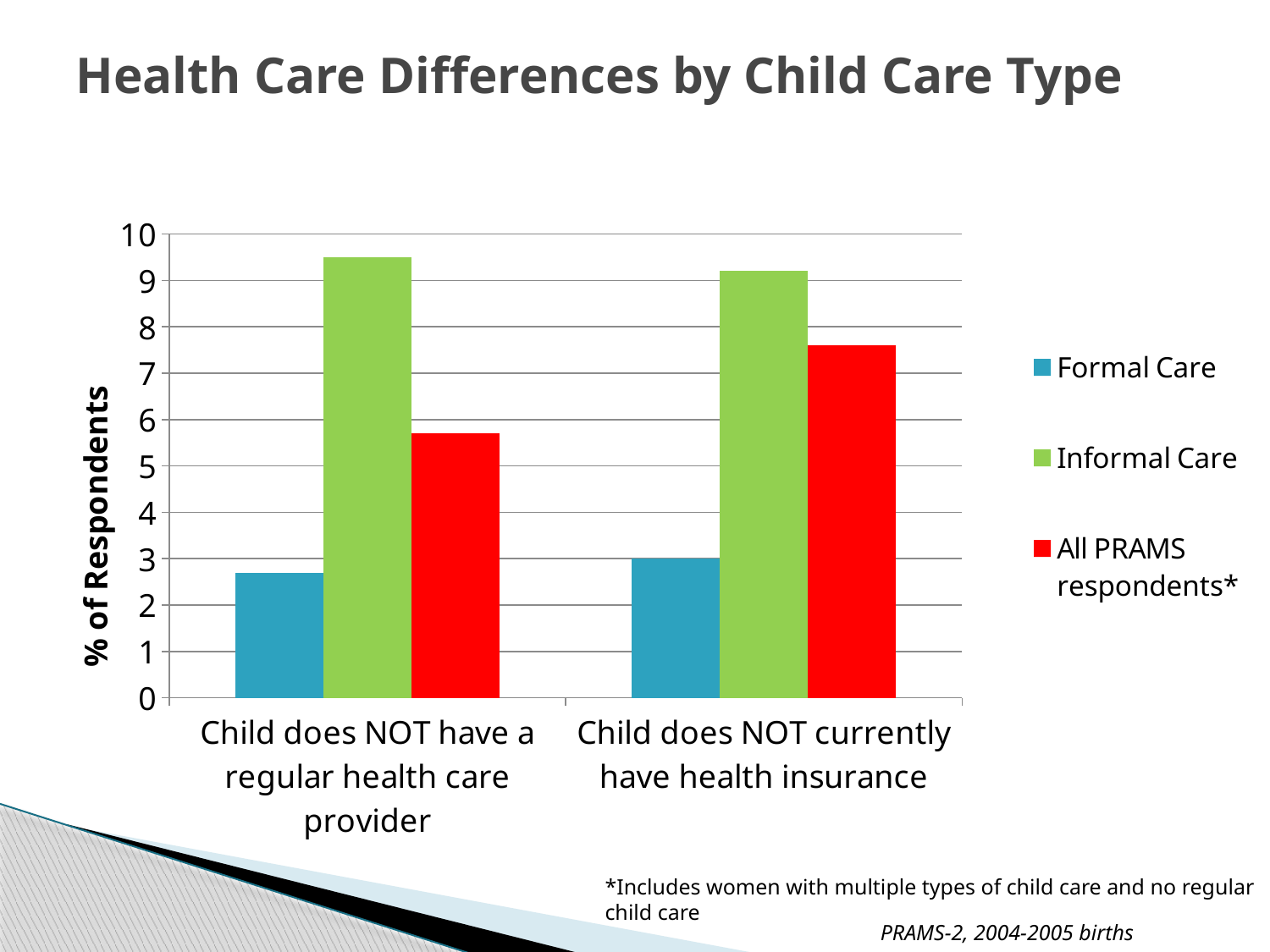
Is the All PRAMS respondents value for "Child does NOT currently have health insurance" greater or less than 7? greater Which series has the highest value for "Child does NOT have a regular health care provider"? Informal Care What kind of chart is shown on the slide? bar chart How many categories are shown on the x axis? 2 What is the title of the chart? Health Care Differences by Child Care Type For "Child does NOT currently have health insurance", which is larger: the Informal Care value or the All PRAMS respondents value? Informal Care What is the label on the y axis? % of Respondents Is the All PRAMS respondents value for "Child does NOT have a regular health care provider" greater or less than 6? less Which series has the lowest value for "Child does NOT currently have health insurance"? Formal Care Is the Informal Care value for "Child does NOT have a regular health care provider" greater or less than 9? greater How many series does the legend list? 3